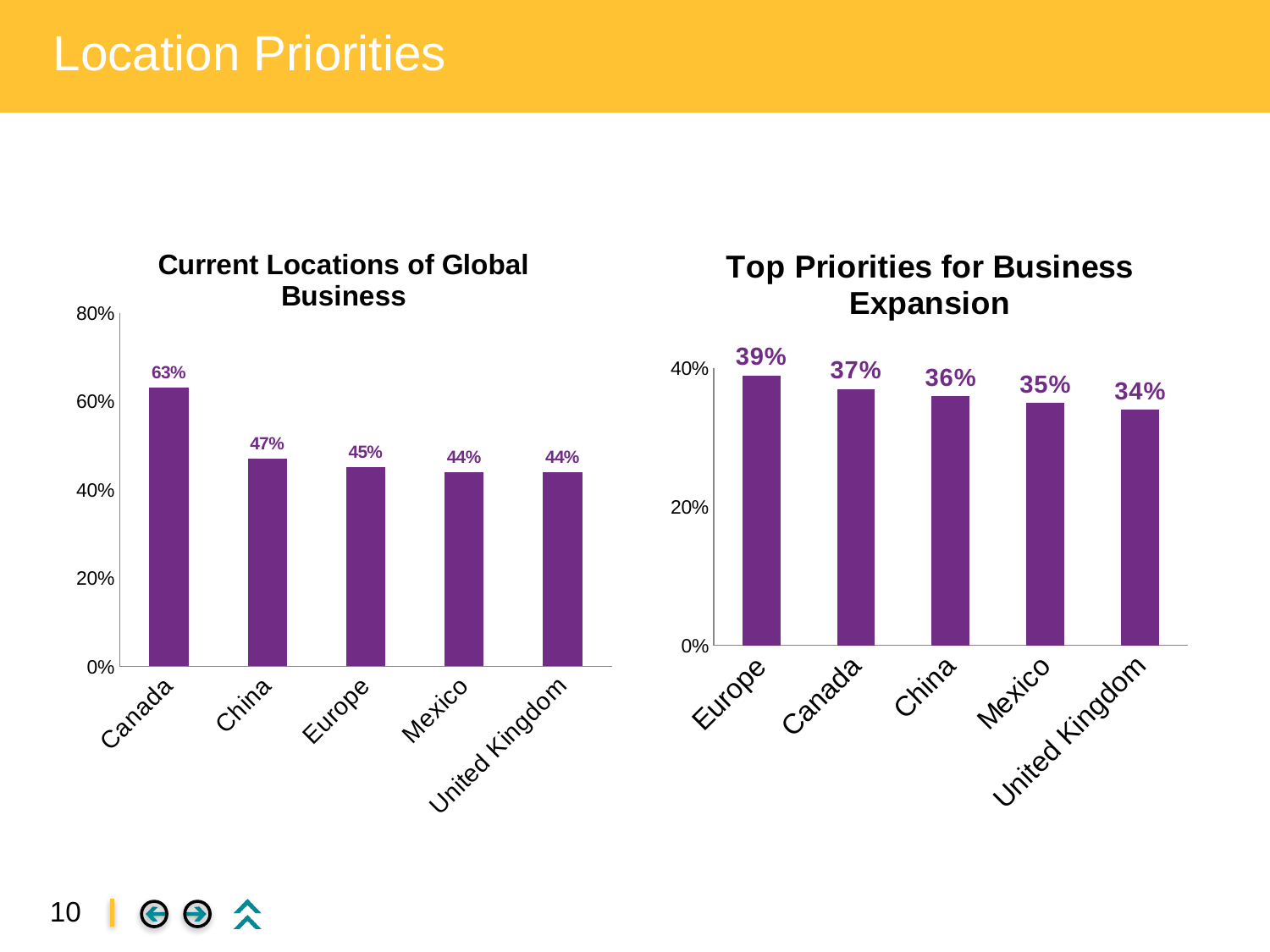
In the 'Top Priorities for Business Expansion' chart, what is the value for Mexico? 35% In the 'Current Locations of Global Business' chart, which is larger, the value for Canada or the value for Europe? Canada In the 'Current Locations of Global Business' chart, what is the value for Canada? 63% In the 'Current Locations of Global Business' chart, what is the difference between the values for Canada and China? 16% In the 'Current Locations of Global Business' chart, which category has the highest value? Canada In the 'Current Locations of Global Business' chart, what is the value for China? 47% In the 'Top Priorities for Business Expansion' chart, what is the value for United Kingdom? 34% In the 'Top Priorities for Business Expansion' chart, which category has the highest value? Europe In the 'Top Priorities for Business Expansion' chart, which category has the lowest value? United Kingdom What kind of chart is the 'Current Locations of Global Business' chart? Bar chart How many categories are shown in the 'Top Priorities for Business Expansion' chart? 5 In the 'Top Priorities for Business Expansion' chart, what is the difference between the values for Europe and United Kingdom? 5%